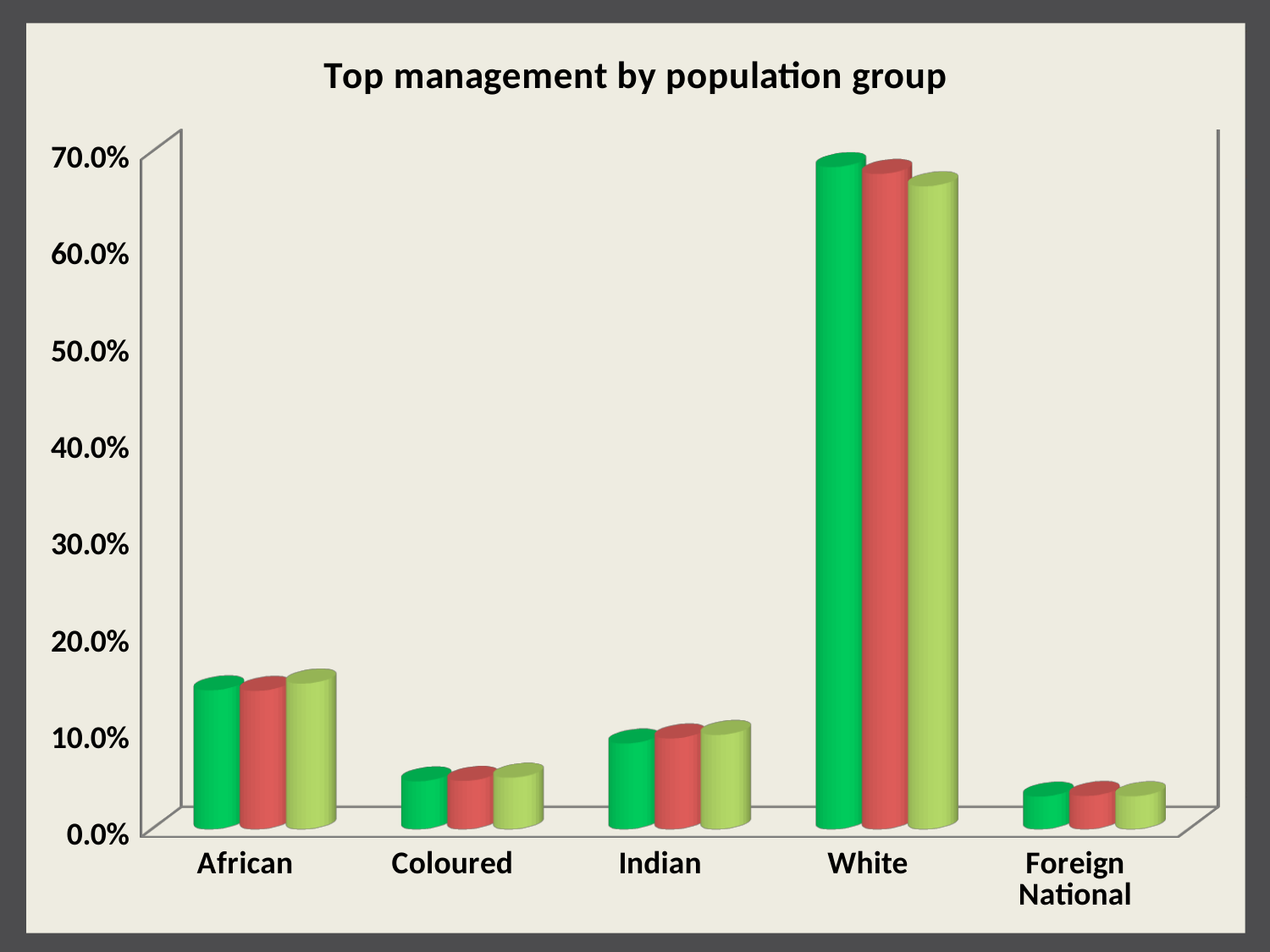
What kind of chart is shown on the slide? bar chart Are the values for White greater or less than 60.0%? greater Are the values for Coloured greater or less than 10.0%? less Which has the larger values, Coloured or Indian? Indian Which has the larger values, African or Indian? African How many population group categories are shown on the x axis? 5 Are the values for African greater or less than 20.0%? less Which population group has the highest share of top management? White What is the title of the chart? Top management by population group Which population group has the lowest share of top management? Foreign National How many bars are plotted for each population group? 3